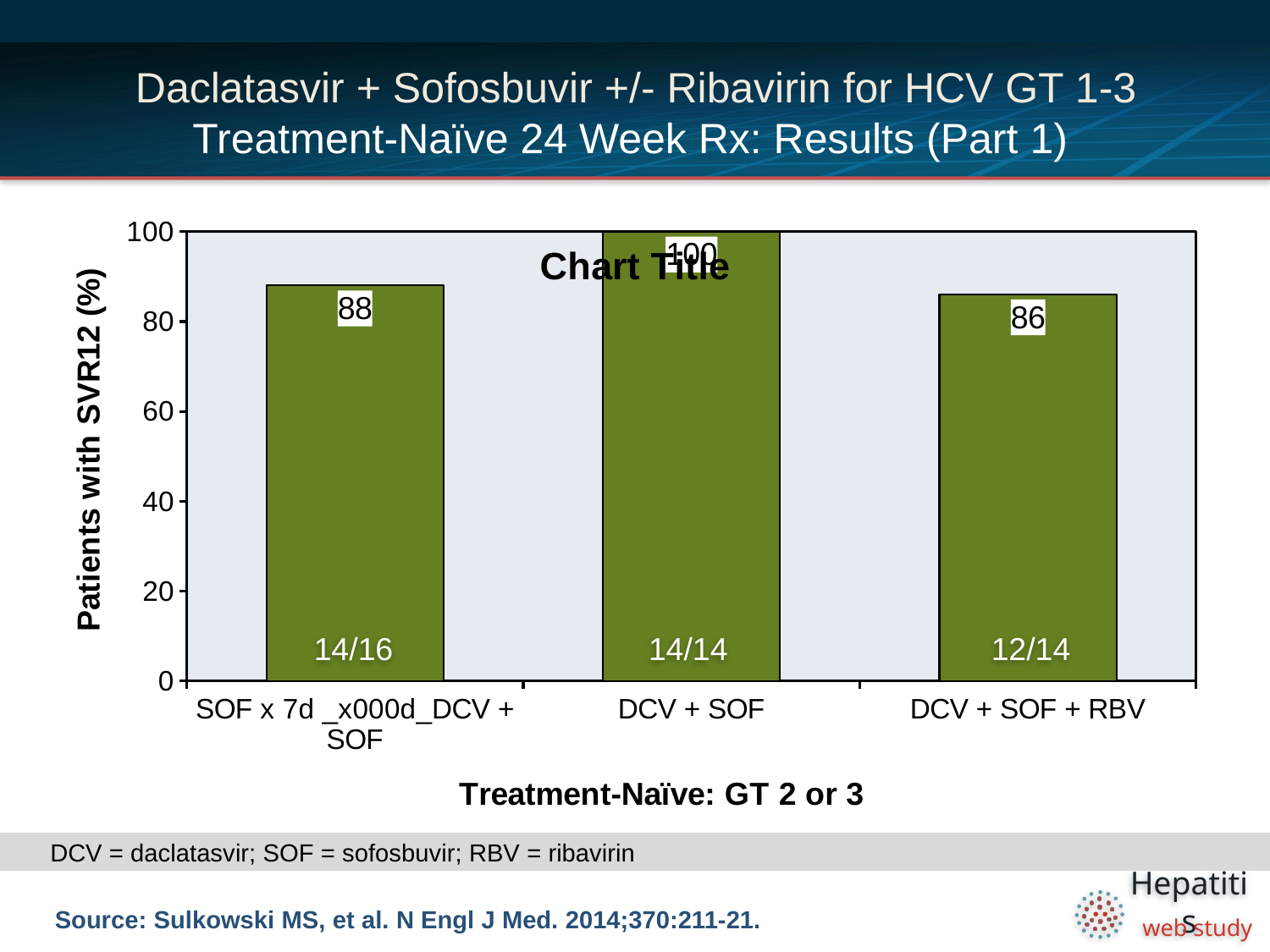
Which is larger, the value for DCV + SOF or the value for DCV + SOF + RBV? DCV + SOF Which category has the highest value? DCV + SOF What is the difference between the values for DCV + SOF and DCV + SOF + RBV? 14 What is the value shown on the leftmost bar (SOF x 7d then DCV + SOF)? 88 What fraction of patients is printed inside the DCV + SOF bar? 14/14 Which category has the lowest value? DCV + SOF + RBV What is the value for DCV + SOF + RBV? 86 How many bars are shown in the chart? 3 What is the label of the vertical axis? Patients with SVR12 (%) What fraction of patients is printed inside the DCV + SOF + RBV bar? 12/14 What kind of chart is shown on the slide? Bar chart What is the value for DCV + SOF? 100